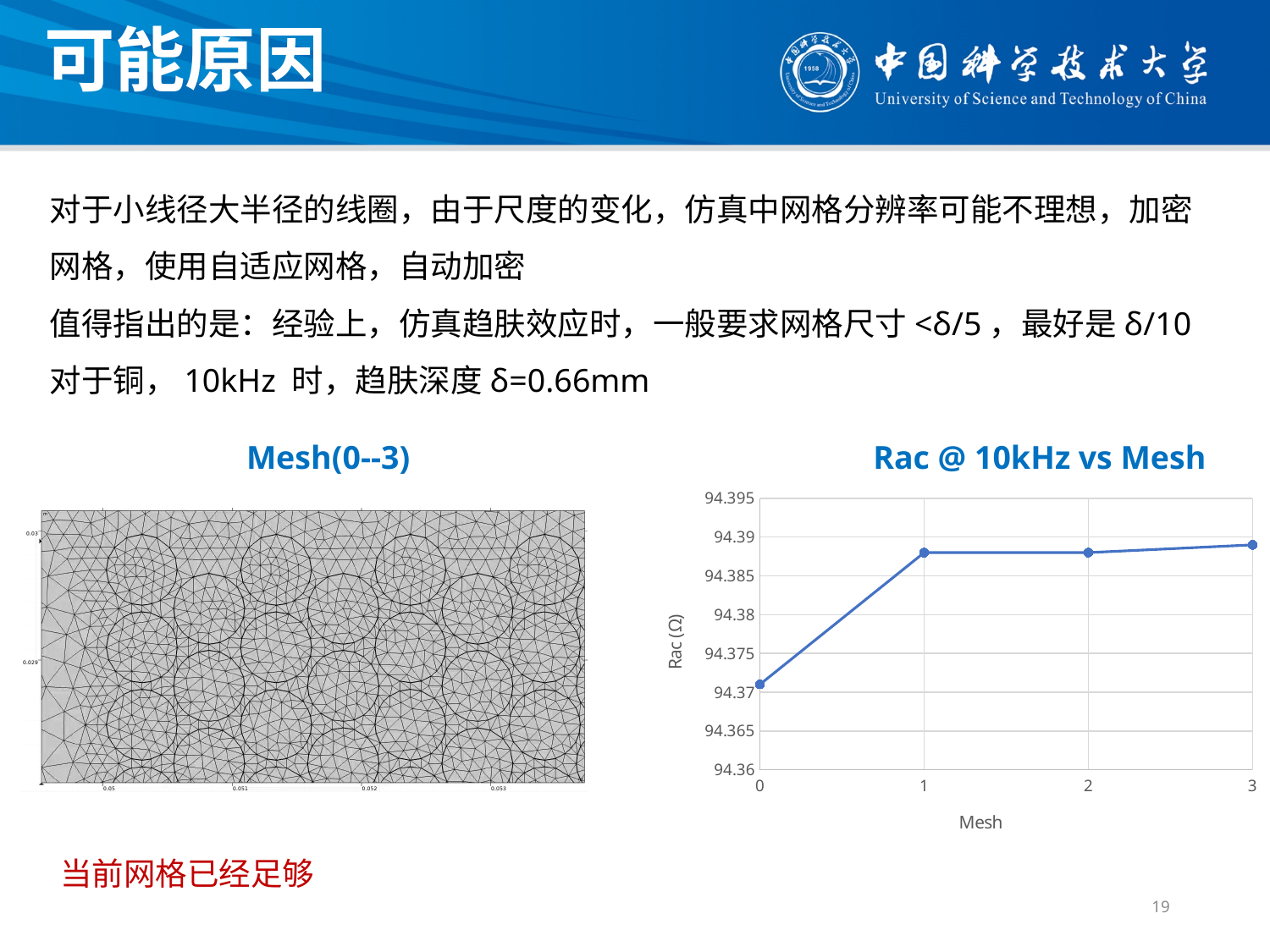
In the "Rac @ 10kHz vs Mesh" chart, what is the highest value shown on the y axis? 94.395 In the "Rac @ 10kHz vs Mesh" chart, at which Mesh value is Rac lowest? 0 In the "Rac @ 10kHz vs Mesh" chart, is the value at Mesh 0 greater or less than 94.375? less In the "Rac @ 10kHz vs Mesh" chart, is the value at Mesh 1 greater or less than 94.385? greater How many data points are plotted in the "Rac @ 10kHz vs Mesh" chart? 4 In the "Rac @ 10kHz vs Mesh" chart, is the value at Mesh 3 greater or less than 94.385? greater What kind of chart is "Rac @ 10kHz vs Mesh"? line chart What is the title of the chart on the right of the slide? Rac @ 10kHz vs Mesh In the "Rac @ 10kHz vs Mesh" chart, which has the larger Rac value, Mesh 0 or Mesh 1? Mesh 1 In the "Rac @ 10kHz vs Mesh" chart, does Rac rise or fall from Mesh 0 to Mesh 1? rise In the "Rac @ 10kHz vs Mesh" chart, what is the label of the y axis? Rac (Ω)